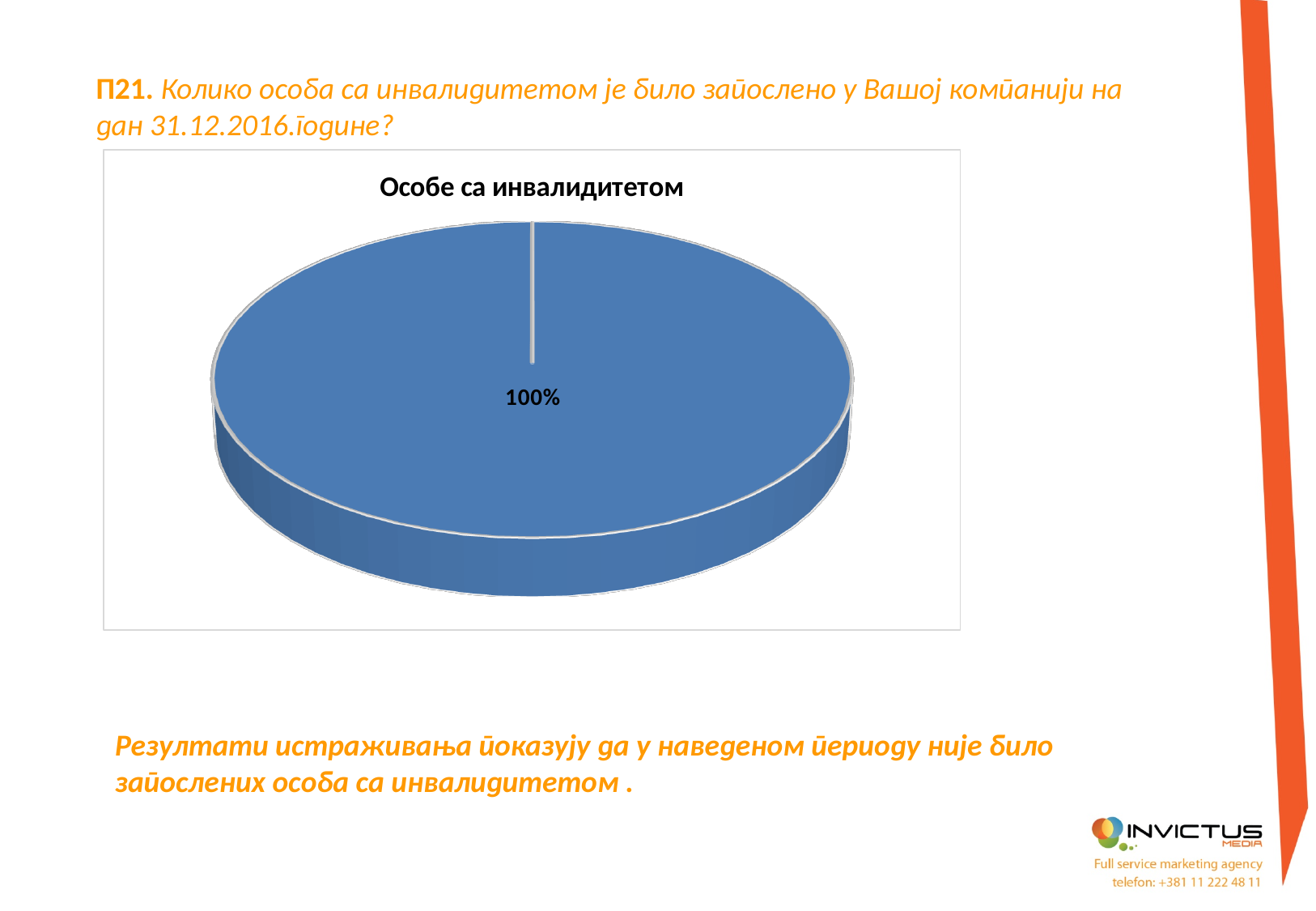
What percentage value is printed on the pie chart? 100% How many slices does the pie chart contain? 1 What is the title of the chart? Особе са инвалидитетом Is the value shown on the pie chart greater or less than 50%? greater What share of the pie does the single slice represent? 100% What colour is the slice of the pie chart? blue What kind of chart is shown on the slide? pie chart